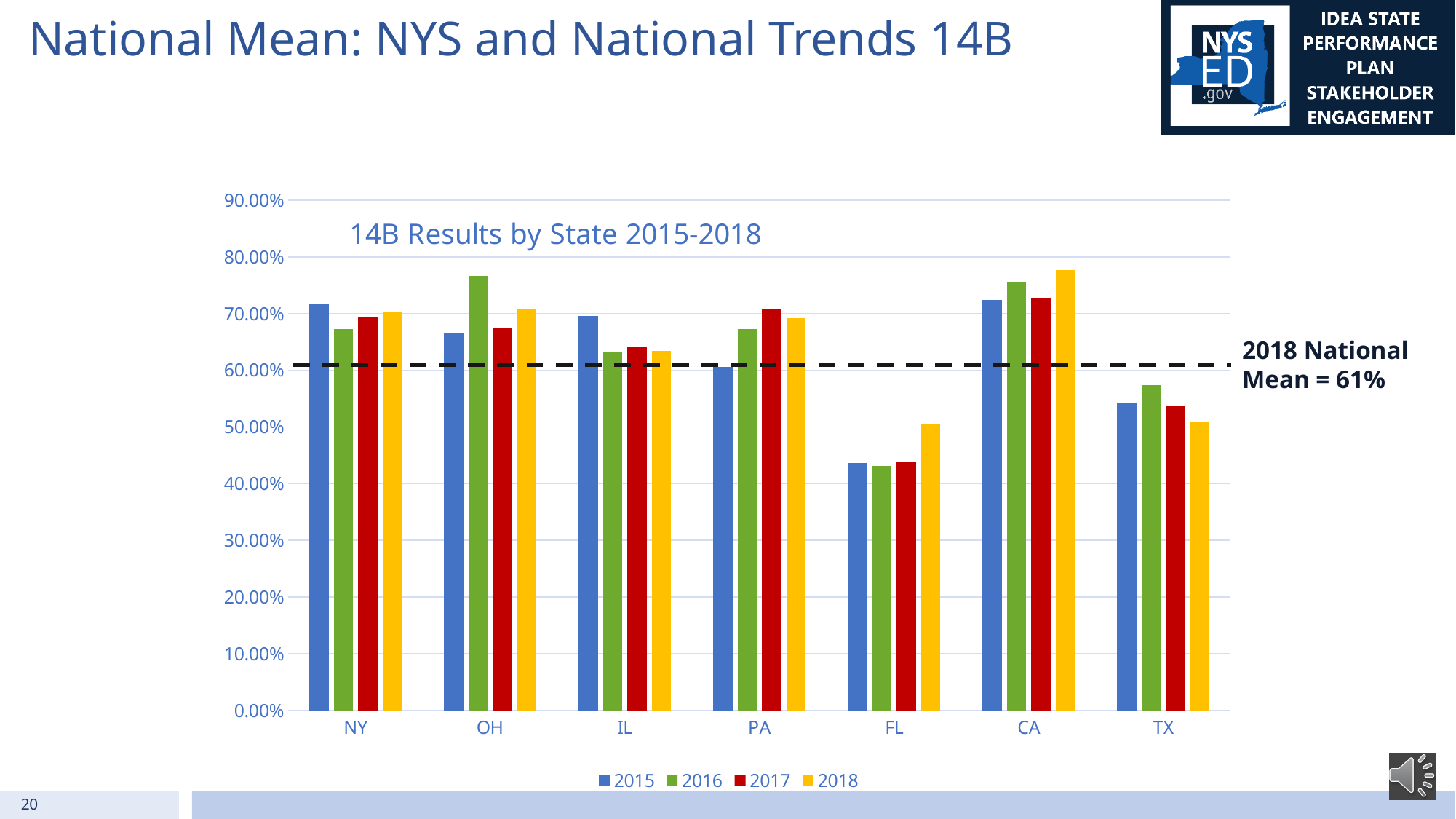
How many states are shown on the x axis of the chart? 7 Which is larger, the 2016 value for OH or the 2016 value for NY? OH Which state has the lowest 2017 value in the chart? FL How many series does the legend list in the 14B Results by State chart? 4 What kind of chart is shown on the slide? Bar chart What is the 2018 National Mean shown by the dashed line on the chart? 61% Is the 2018 value for TX greater or less than 60.00%? less Is the 2018 value for CA greater or less than 70.00%? greater Which state has the highest 2018 value in the chart? CA Is the 2015 value for FL greater or less than 50.00%? less What is the title of the chart on the slide? 14B Results by State 2015-2018